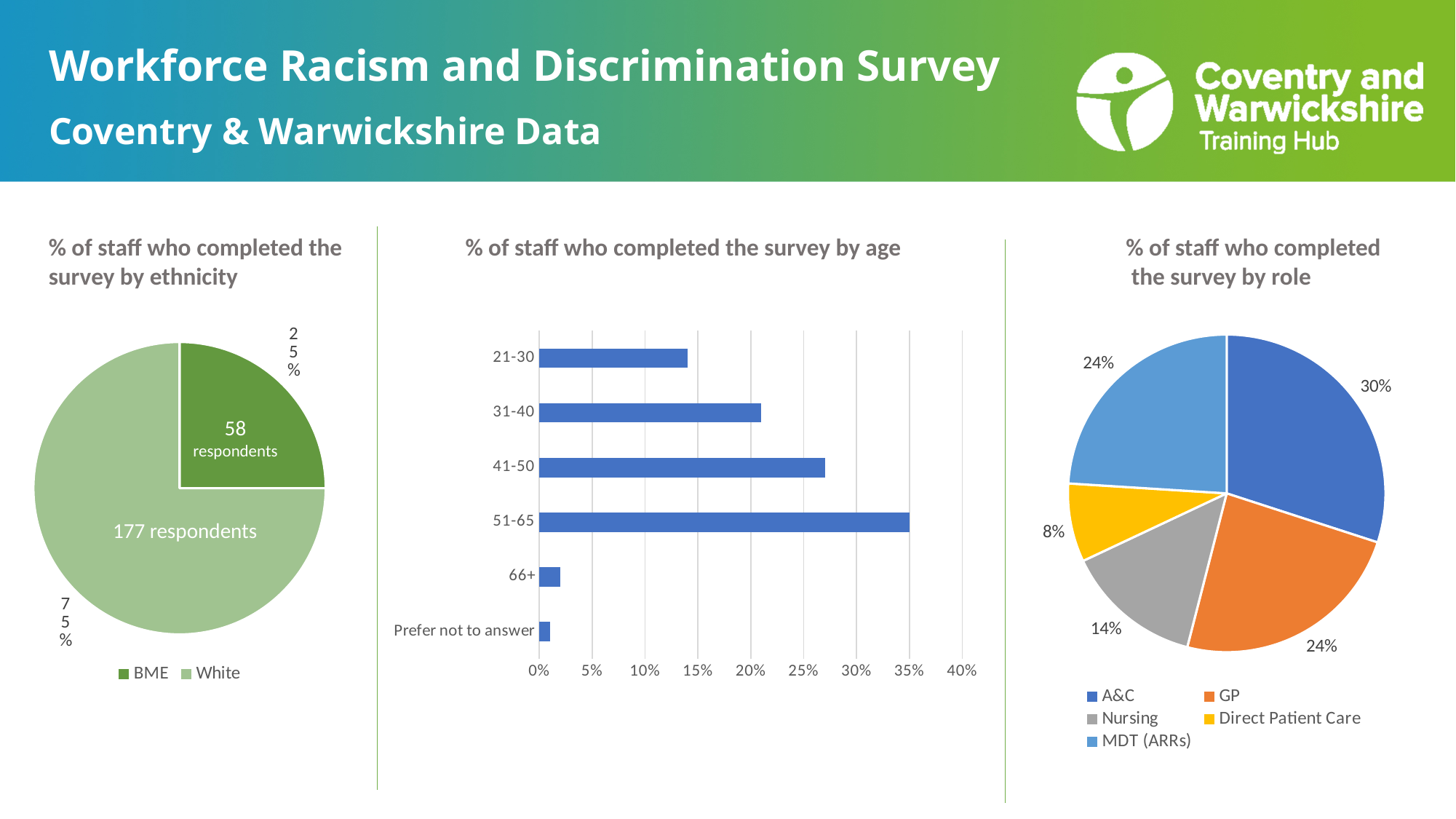
In the '% of staff who completed the survey by role' chart, which role has the smallest share? Direct Patient Care In the '% of staff who completed the survey by age' chart, which age group has the highest percentage? 51-65 In the '% of staff who completed the survey by ethnicity' chart, how many more White respondents were there than BME respondents? 119 How many entries does the legend of the '% of staff who completed the survey by role' chart list? 5 In the '% of staff who completed the survey by age' chart, is the value for 21-30 greater or less than 15%? less In the '% of staff who completed the survey by role' chart, what share of the pie is Nursing? 14% What kind of chart is '% of staff who completed the survey by age'? Bar chart In the '% of staff who completed the survey by ethnicity' chart, what share of the pie is BME? 25% In the '% of staff who completed the survey by ethnicity' chart, how many respondents were White? 177 respondents In the '% of staff who completed the survey by age' chart, which is larger, the value for 31-40 or the value for 41-50? 41-50 In the '% of staff who completed the survey by age' chart, is the value for 41-50 greater or less than 25%? greater In the '% of staff who completed the survey by age' chart, how many age categories are shown? 6